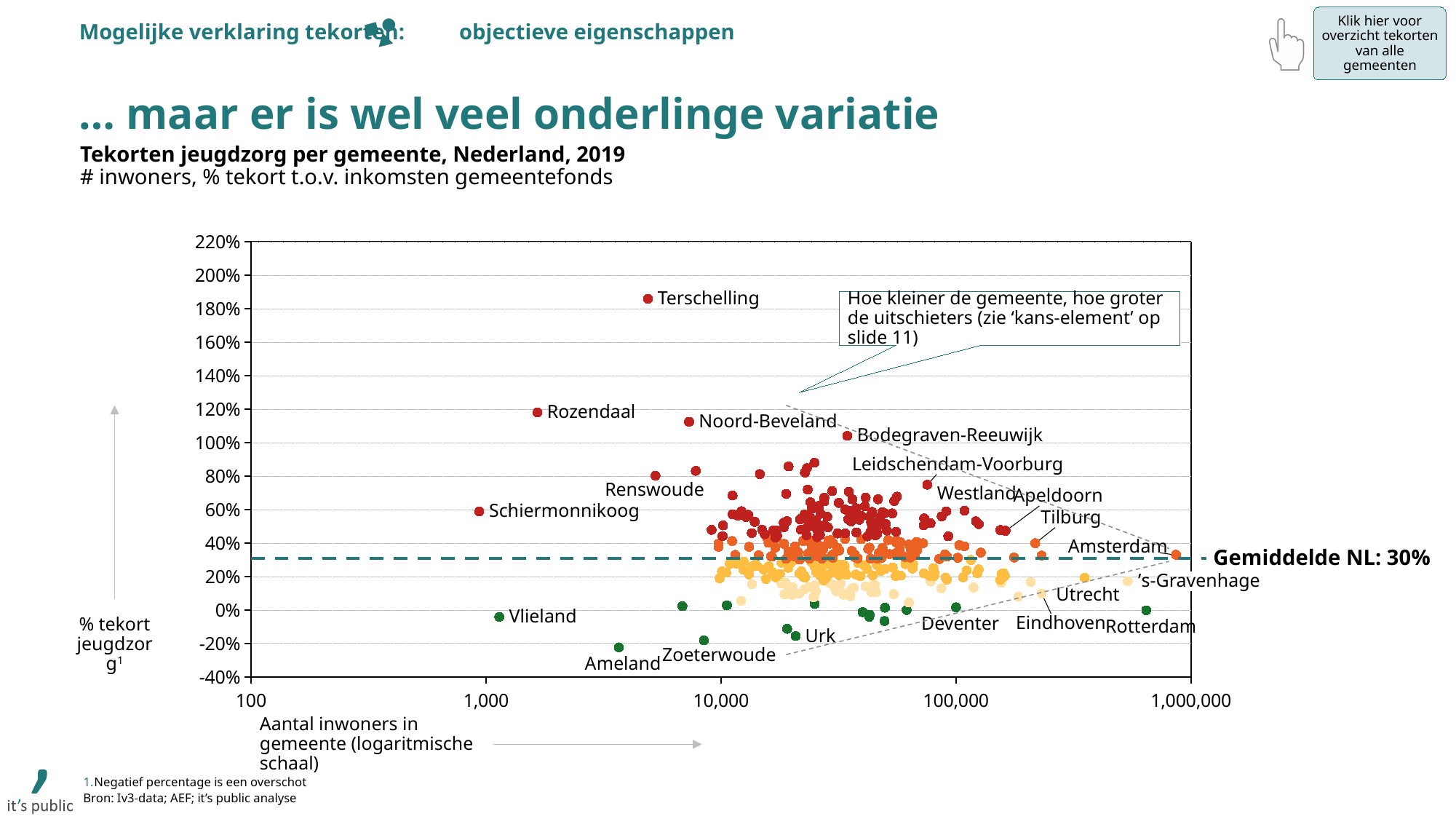
Which has a higher % tekort jeugdzorg, Schiermonnikoog or Vlieland? Schiermonnikoog What kind of chart is shown on the slide? scatter chart Is the value for Rotterdam greater or less than 20%? less Which has a higher % tekort jeugdzorg, Terschelling or Rozendaal? Terschelling Does the spread of values widen or narrow as the number of inhabitants increases along the x axis? narrow Is the value for Rozendaal greater or less than 100%? greater Which labelled municipality has the lowest % tekort jeugdzorg? Ameland What is the title of the chart? Tekorten jeugdzorg per gemeente, Nederland, 2019 What is the value of the dashed 'Gemiddelde NL' reference line? 30% Is the value for Terschelling greater or less than 160%? greater Which labelled municipality has the highest % tekort jeugdzorg? Terschelling